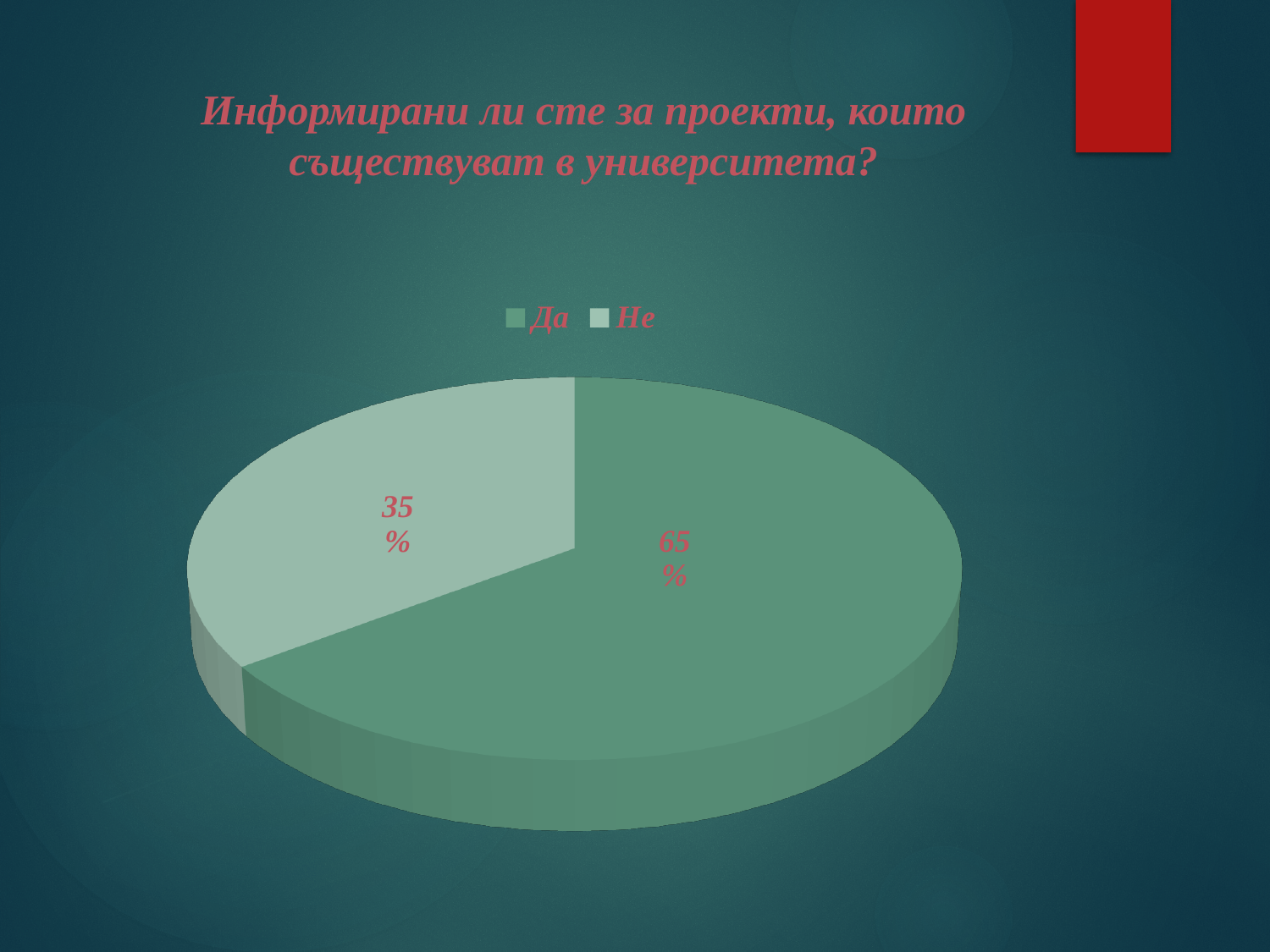
What share of the pie does the "Да" slice represent? 65% What is the difference in percentage points between the "Да" and "Не" slices? 30 What share of the pie does the "Не" slice represent? 35% Which category has the largest slice of the pie? Да How many entries does the legend list? 2 How many categories does the pie chart show? 2 Which legend entry is shown in the lighter green colour? Не What is the title of the chart? Информирани ли сте за проекти, които съществуват в университета? Which is larger, the "Да" slice or the "Не" slice? Да What kind of chart is shown on the slide? Pie chart Which category has the smallest slice of the pie? Не